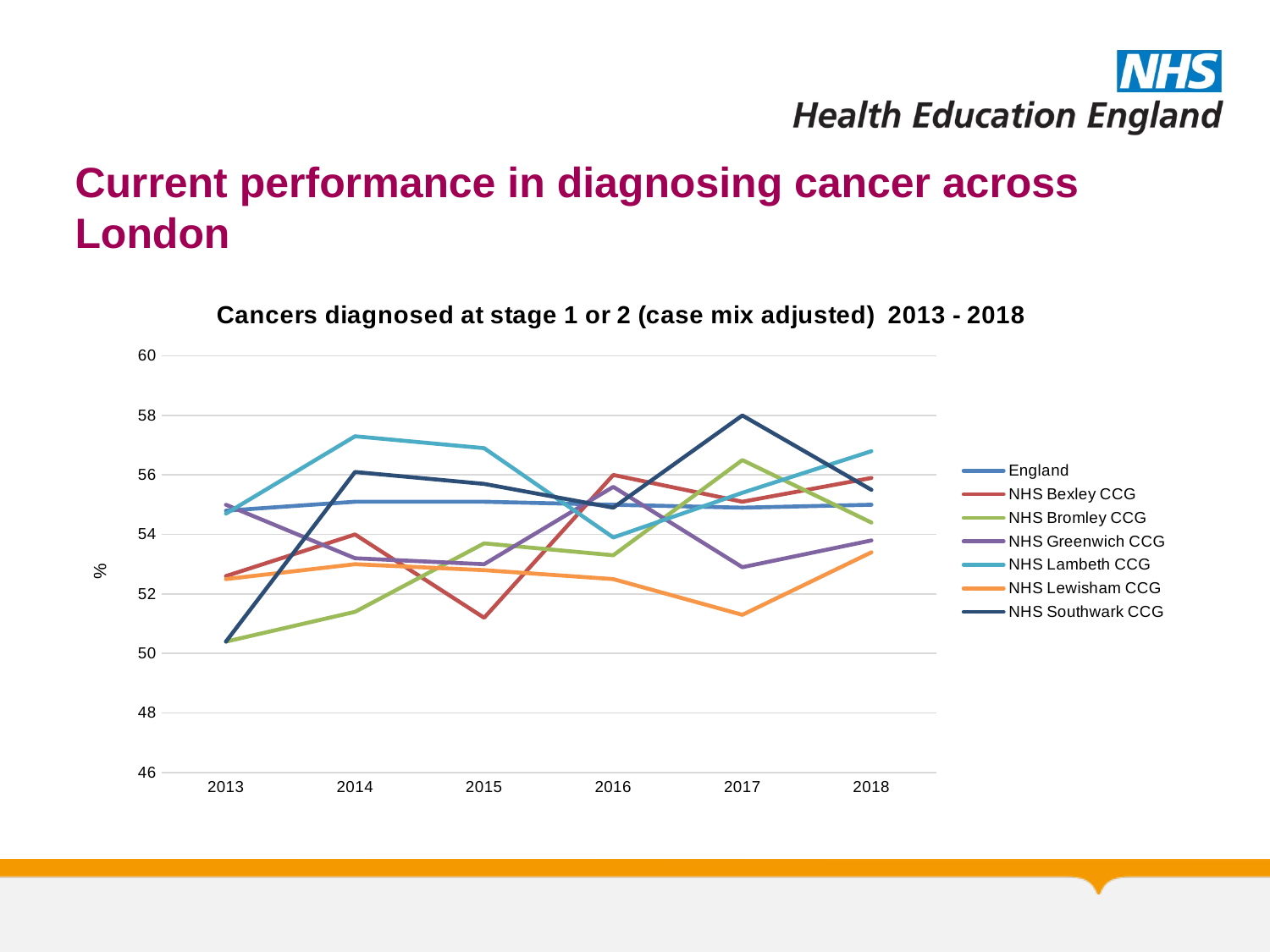
In 2018, which is higher: NHS Lambeth CCG or NHS Bromley CCG? NHS Lambeth CCG Is the value for NHS Lewisham CCG in 2017 greater or less than 52? less What kind of chart is shown on the slide? Line chart What is the title of the chart? Cancers diagnosed at stage 1 or 2 (case mix adjusted) 2013 - 2018 Is the value for NHS Southwark CCG in 2013 greater or less than 52? less Is the value for NHS Lambeth CCG in 2014 greater or less than 56? greater Which series has the highest value in 2017? NHS Southwark CCG Does the value for NHS Southwark CCG rise or fall from 2013 to 2014? rise How many years are plotted along the x axis? 6 Which series has the lowest value in 2015? NHS Bexley CCG What is the label on the vertical axis? % How many series does the legend list? 7